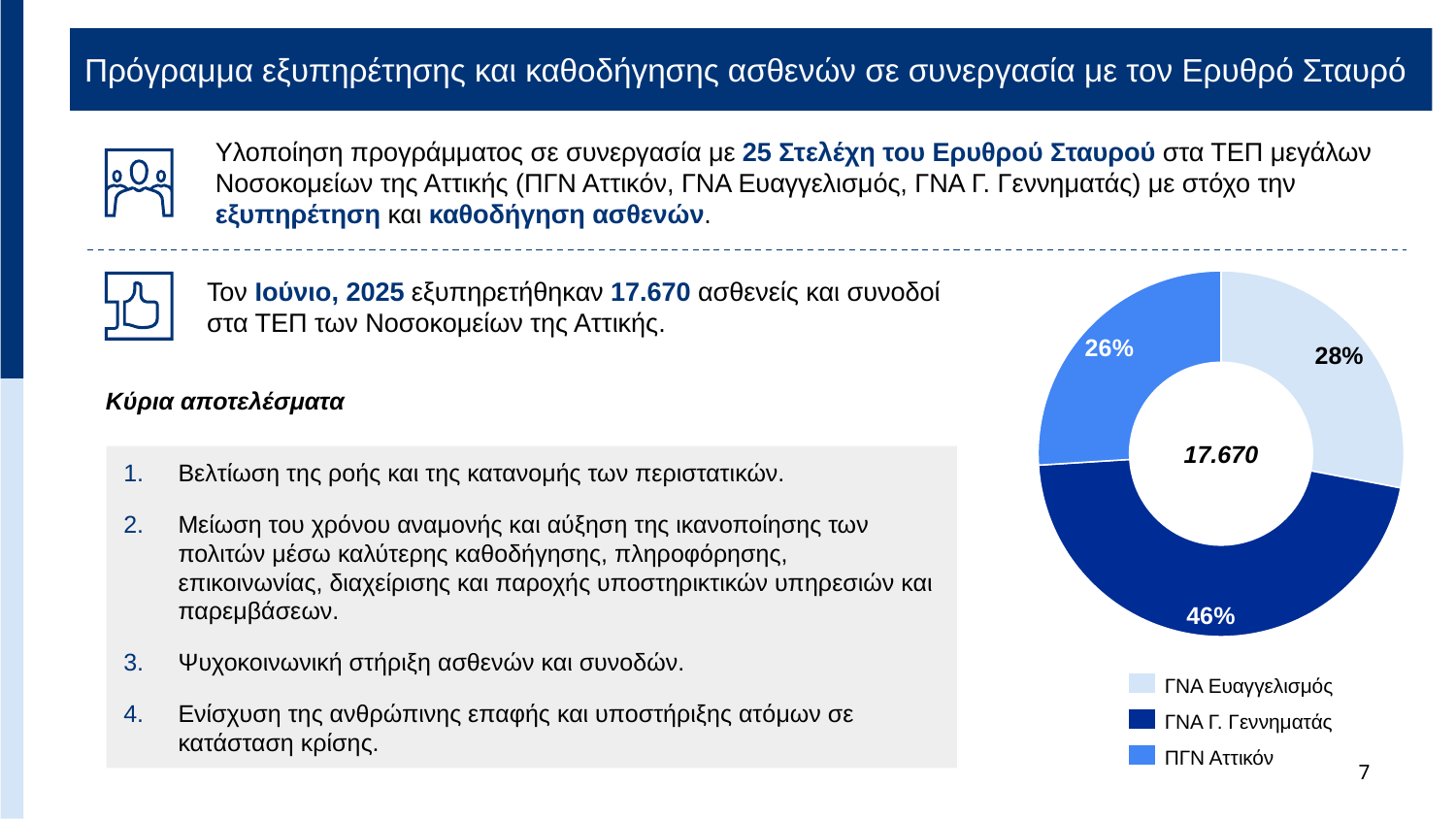
Which hospital has the smallest slice in the pie chart? ΠΓΝ Αττικόν Which hospital is represented by the darkest blue slice in the pie chart? ΓΝΑ Γ. Γεννηματάς How many slices does the pie chart have? 3 How many entries does the legend of the pie chart list? 3 What share of the pie chart does ΓΝΑ Ευαγγελισμός account for? 28% Which has a larger share in the pie chart, ΓΝΑ Ευαγγελισμός or ΠΓΝ Αττικόν? ΓΝΑ Ευαγγελισμός Which hospital has the largest slice in the pie chart? ΓΝΑ Γ. Γεννηματάς What is the difference in percentage points between the shares of ΓΝΑ Γ. Γεννηματάς and ΓΝΑ Ευαγγελισμός? 18 percentage points What number is printed in the centre of the donut chart? 17.670 What kind of chart is shown on the slide? Pie (donut) chart What share of the pie chart does ΓΝΑ Γ. Γεννηματάς account for? 46% What share of the pie chart does ΠΓΝ Αττικόν account for? 26%